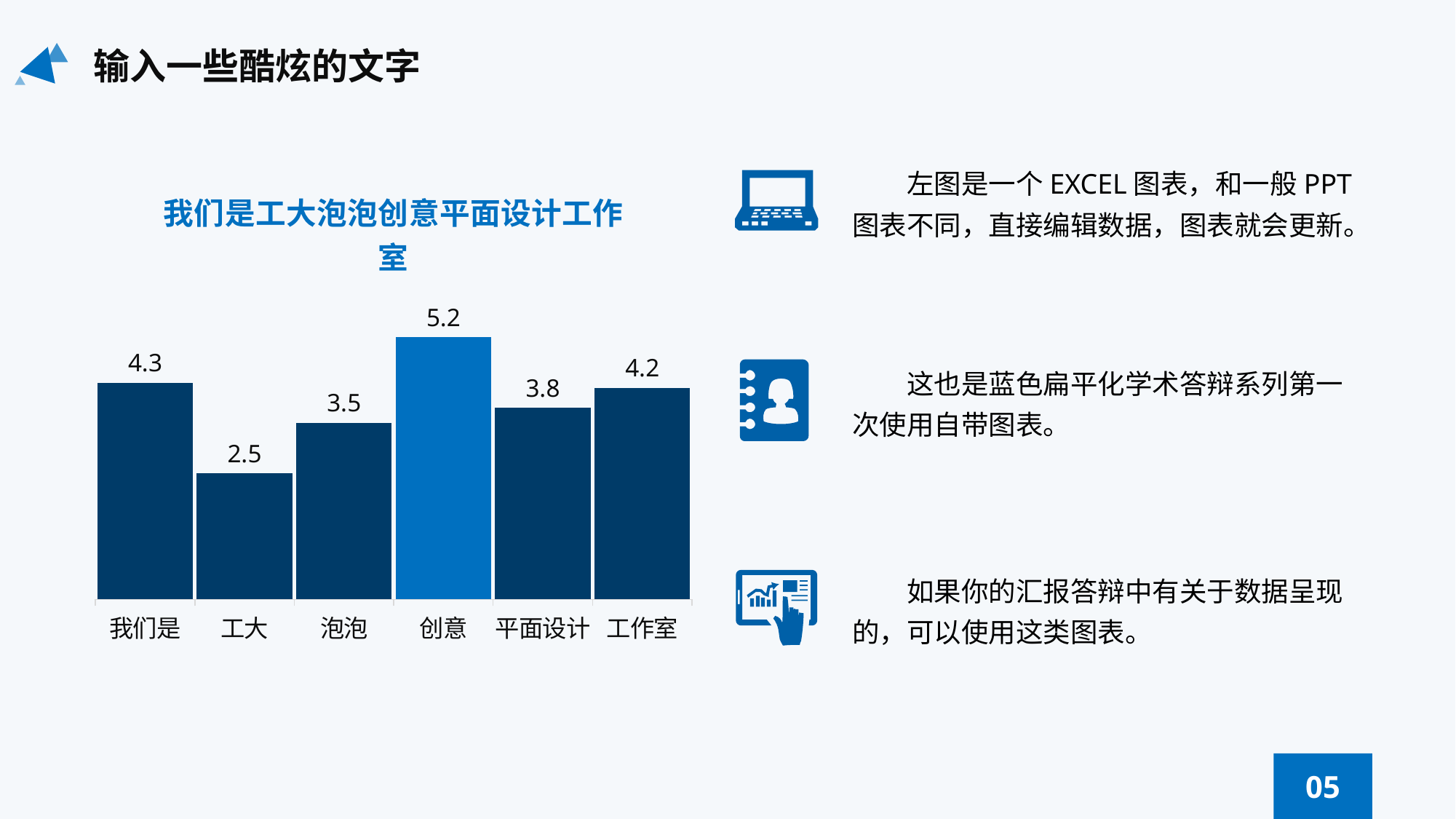
How many categories are shown in the chart? 6 What is the value for 工大? 2.5 Which bar is shown in a lighter blue colour than the others? 创意 What is the value for 平面设计? 3.8 Which is larger, the value for 泡泡 or the value for 平面设计? 平面设计 Which category has the highest value? 创意 Which category has the lowest value? 工大 What is the difference between the values for 我们是 and 工作室? 0.1 What is the title of the chart? 我们是工大泡泡创意平面设计工作室 What is the value for 创意? 5.2 What is the difference between the values for 创意 and 工大? 2.7 What kind of chart is shown on the slide? Bar chart